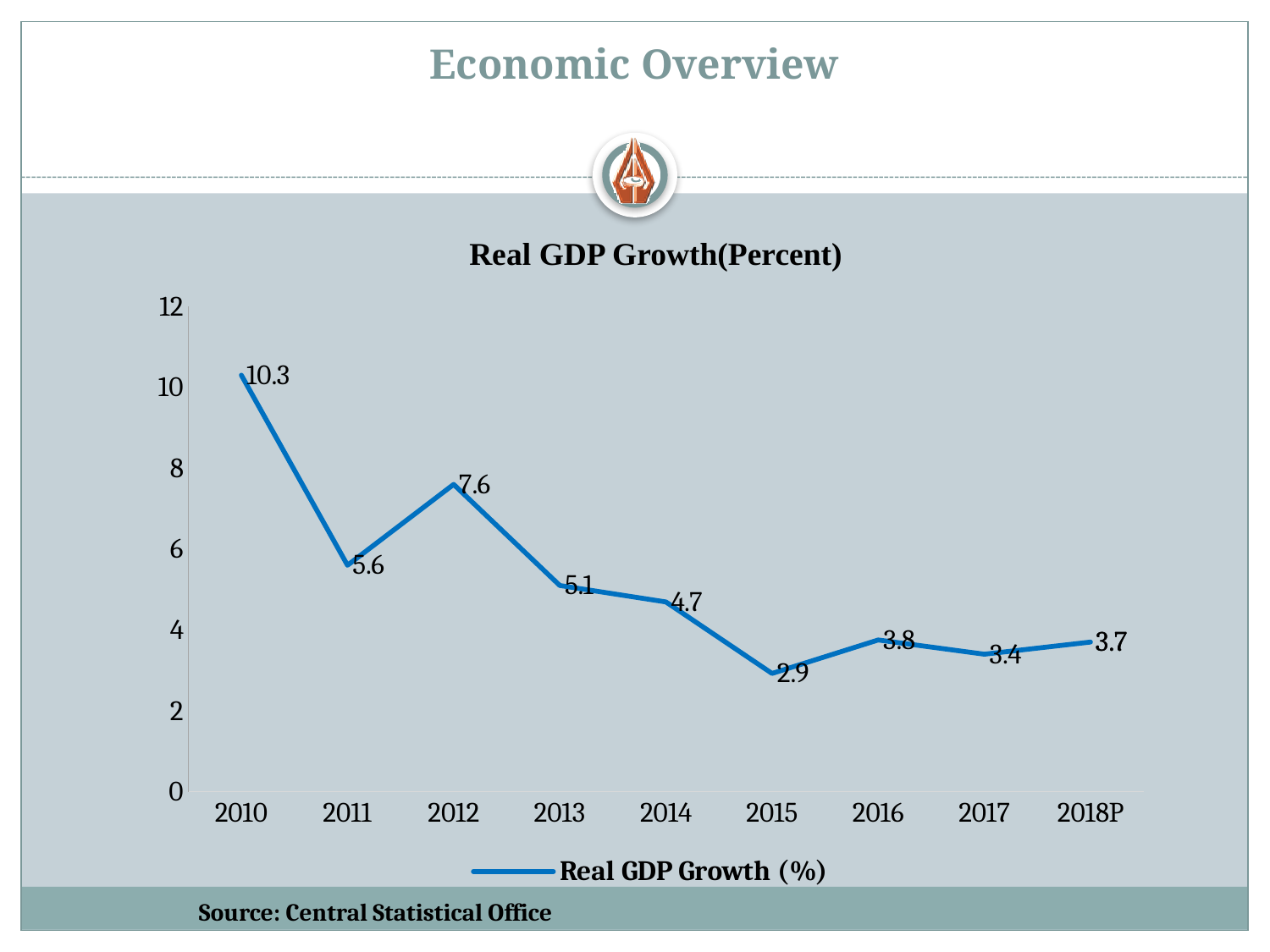
What is the Real GDP Growth value for 2010? 10.3 What is the Real GDP Growth value for 2018P? 3.7 What kind of chart is shown on the slide? line chart What is the difference between the Real GDP Growth values for 2010 and 2011? 4.7 Which year has the highest Real GDP Growth? 2010 Which year has a larger Real GDP Growth value, 2016 or 2017? 2016 Is the Real GDP Growth value for 2012 greater or less than 8? less What is the title of the chart? Real GDP Growth(Percent) How many years are plotted on the x axis? 9 What is the Real GDP Growth value for 2015? 2.9 Which year has the lowest Real GDP Growth? 2015 What is the difference between the Real GDP Growth values for 2012 and 2013? 2.5